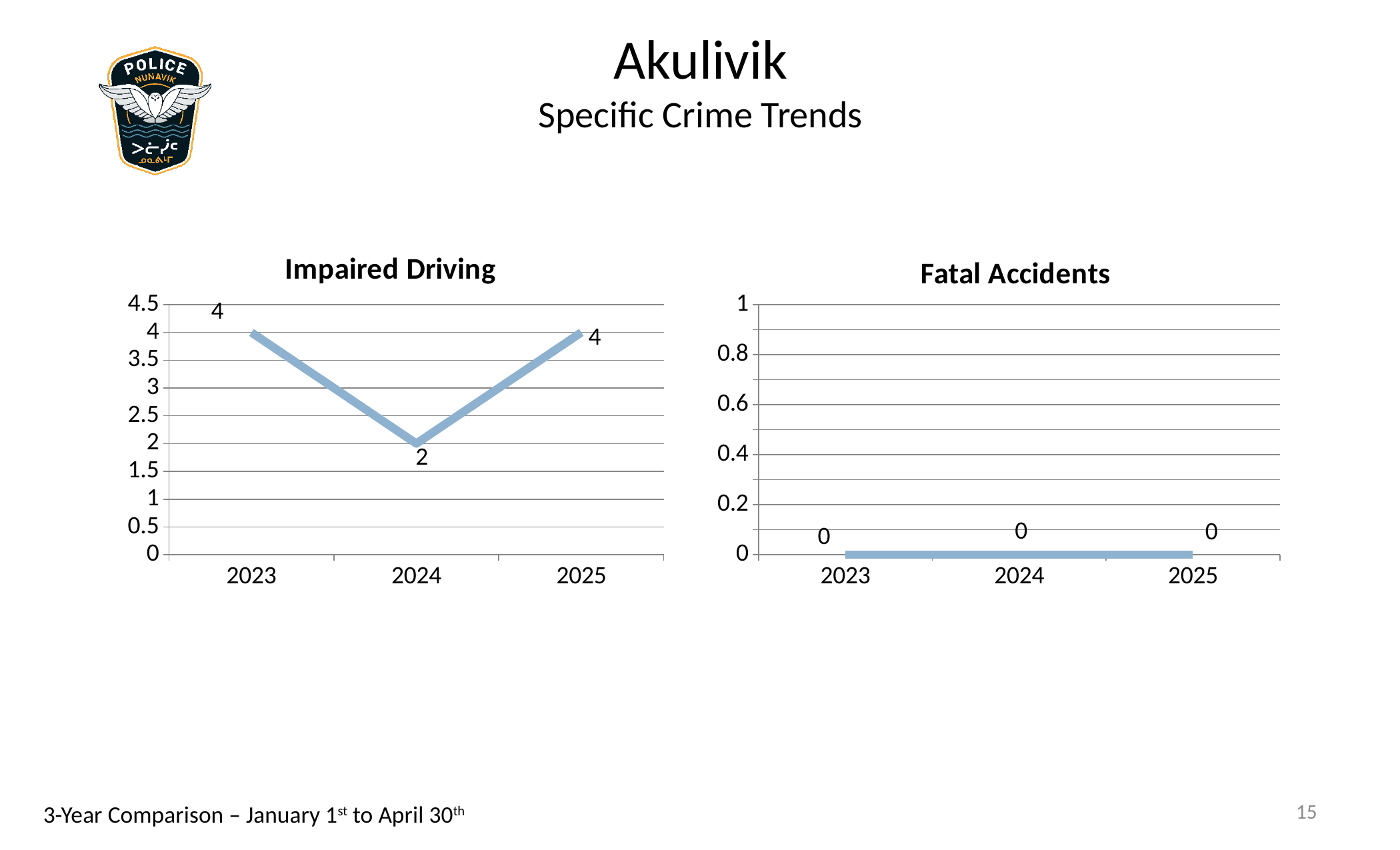
In the Impaired Driving chart, what is the value for 2025? 4 What kind of chart is the Impaired Driving chart? line chart In the Impaired Driving chart, what is the difference between the 2023 value and the 2024 value? 2 How many years are plotted in the Fatal Accidents chart? 3 What is the title of the chart on the right side of the slide? Fatal Accidents In the Impaired Driving chart, is the value for 2024 greater or less than 3? less In the Fatal Accidents chart, what is the value for 2024? 0 In the Impaired Driving chart, what is the value for 2023? 4 In the Fatal Accidents chart, what is the value for 2025? 0 In the Impaired Driving chart, what is the value for 2024? 2 In the Impaired Driving chart, does the value rise or fall from 2024 to 2025? rise In the Impaired Driving chart, which year has the lowest value? 2024